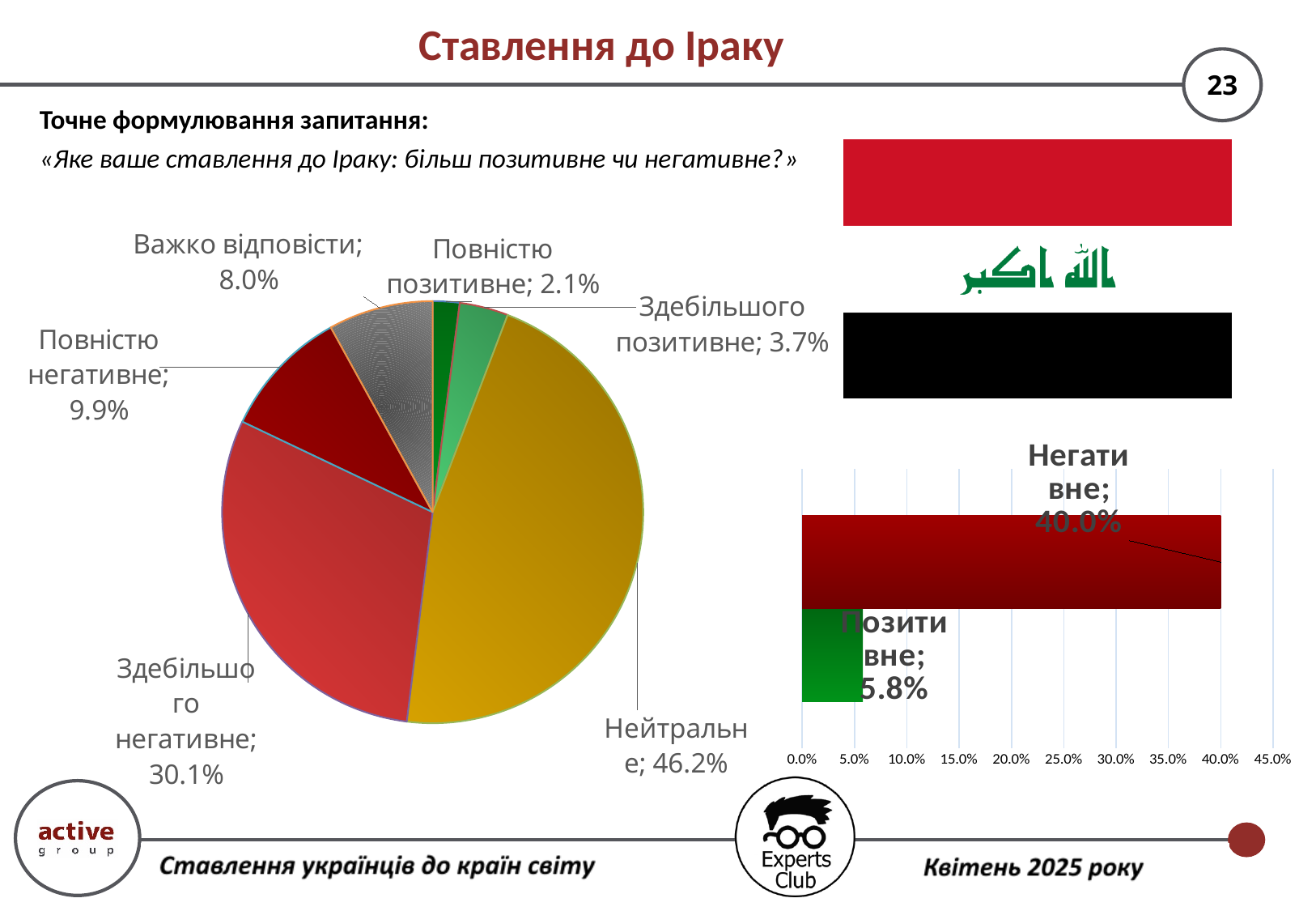
How many categories does the pie chart show? 6 In the bar chart on the right, what is the value for «Негативне»? 40.0% In the pie chart, what is the difference between «Повністю негативне» and «Здебільшого позитивне»? 6.2% What type of chart is shown at the bottom right of the slide? Bar chart In the pie chart, what share of respondents answered «Нейтральне»? 46.2% In the bar chart on the right, what is the difference between «Негативне» and «Позитивне»? 34.2% In the pie chart, which category has the largest share? Нейтральне In the pie chart, which is larger: «Повністю негативне» or «Важко відповісти»? Повністю негативне In the pie chart, which category has the smallest share? Повністю позитивне In the pie chart, what is the value for «Повністю позитивне»? 2.1% In the pie chart, what is the value for «Важко відповісти»? 8.0% In the pie chart, what is the value for «Здебільшого негативне»? 30.1%